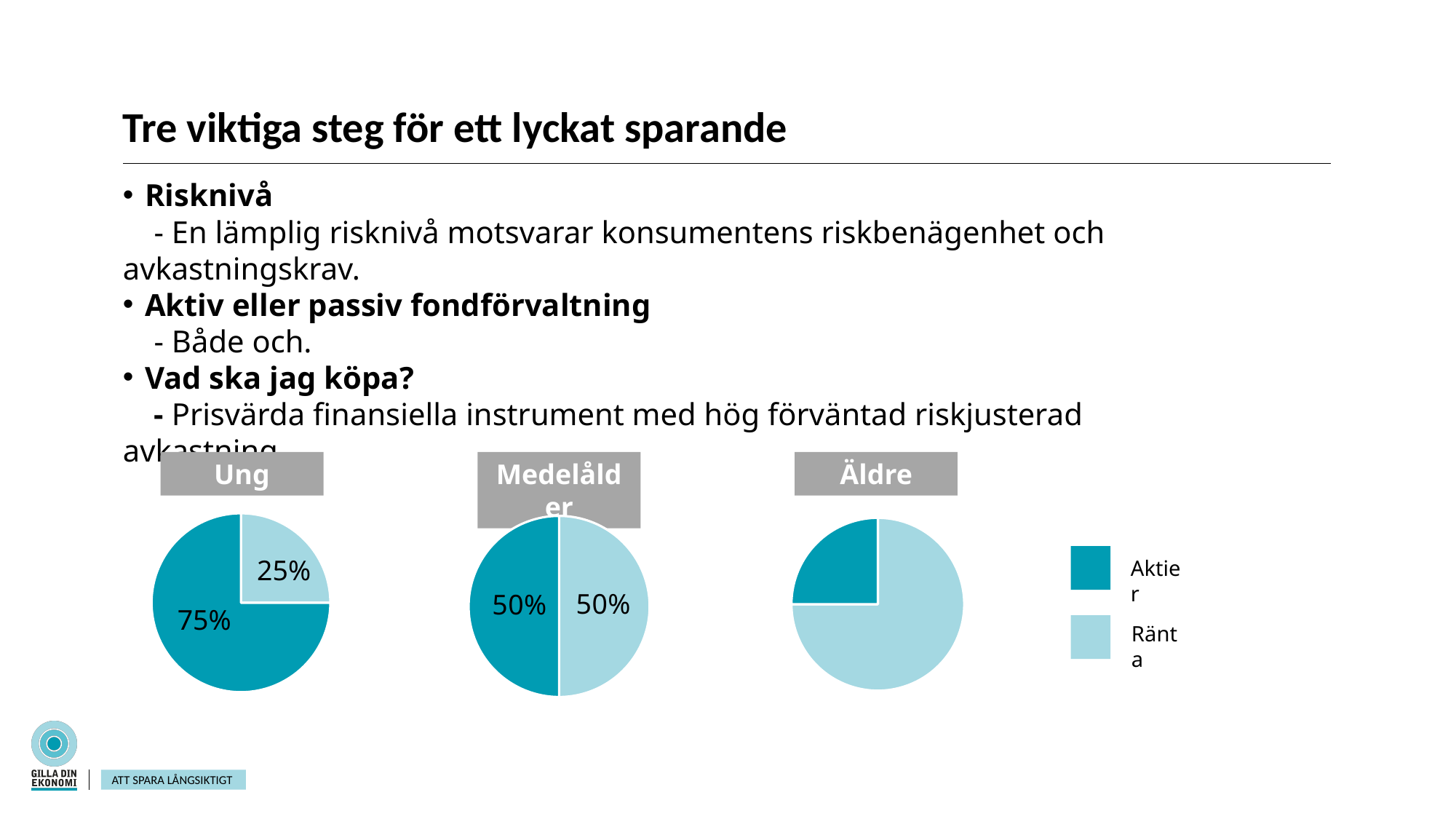
In the Äldre pie chart, which slice is larger, Aktier or Ränta? Ränta In the Ung pie chart, which slice is larger, Aktier or Ränta? Aktier How many slices does the Ung pie chart have? 2 What are the two legend entries shown next to the pie charts? Aktier and Ränta How many pie charts are shown on the slide? 3 How many entries does the legend next to the pie charts list? 2 In the Ung pie chart, what share is labelled for Aktier? 75% In the Medelålder pie chart, what share is labelled for Ränta? 50% In the Ung pie chart, what share is labelled for Ränta? 25% What kind of chart is used for the Ung, Medelålder and Äldre charts? Pie chart In the Ung pie chart, what is the difference in percentage points between the Aktier and Ränta slices? 50 percentage points In the Medelålder pie chart, what share is labelled for Aktier? 50%